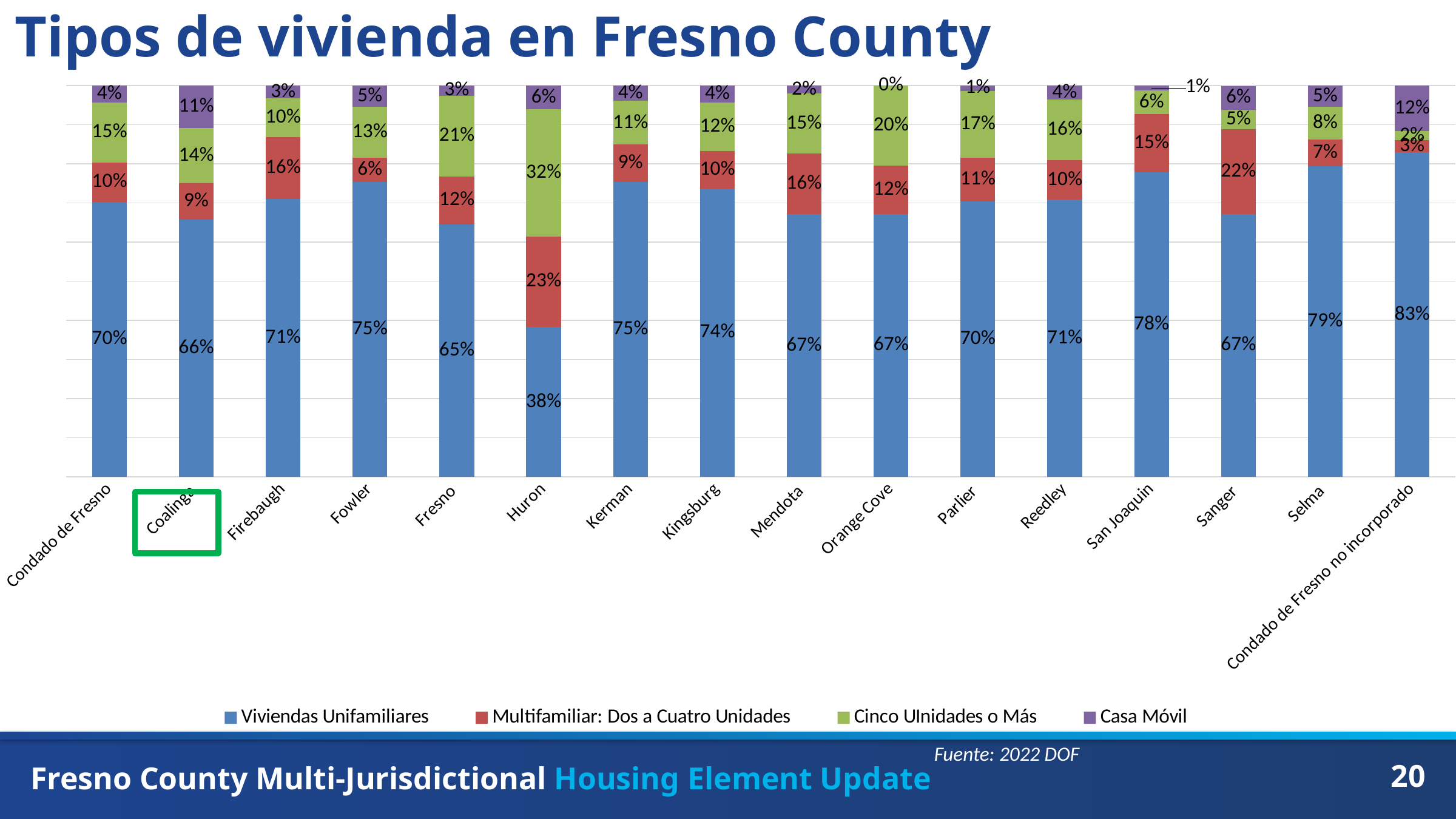
How many categories are shown along the x axis? 16 How many series does the legend list? 4 What is the Cinco UInidades o Más value for Fresno? 21% What is the Casa Móvil value for Coalinga? 11% Which is larger, the Cinco UInidades o Más value for Orange Cove or for Parlier? Orange Cove What is the Viviendas Unifamiliares value for Huron? 38% What kind of chart is shown on the slide? Stacked bar chart What is the title of the chart? Tipos de vivienda en Fresno County Which category has the lowest Viviendas Unifamiliares value? Huron What is the Multifamiliar: Dos a Cuatro Unidades value for Sanger? 22% What is the difference between the Viviendas Unifamiliares values for Selma and Coalinga? 13% Which category has the highest Viviendas Unifamiliares value? Condado de Fresno no incorporado